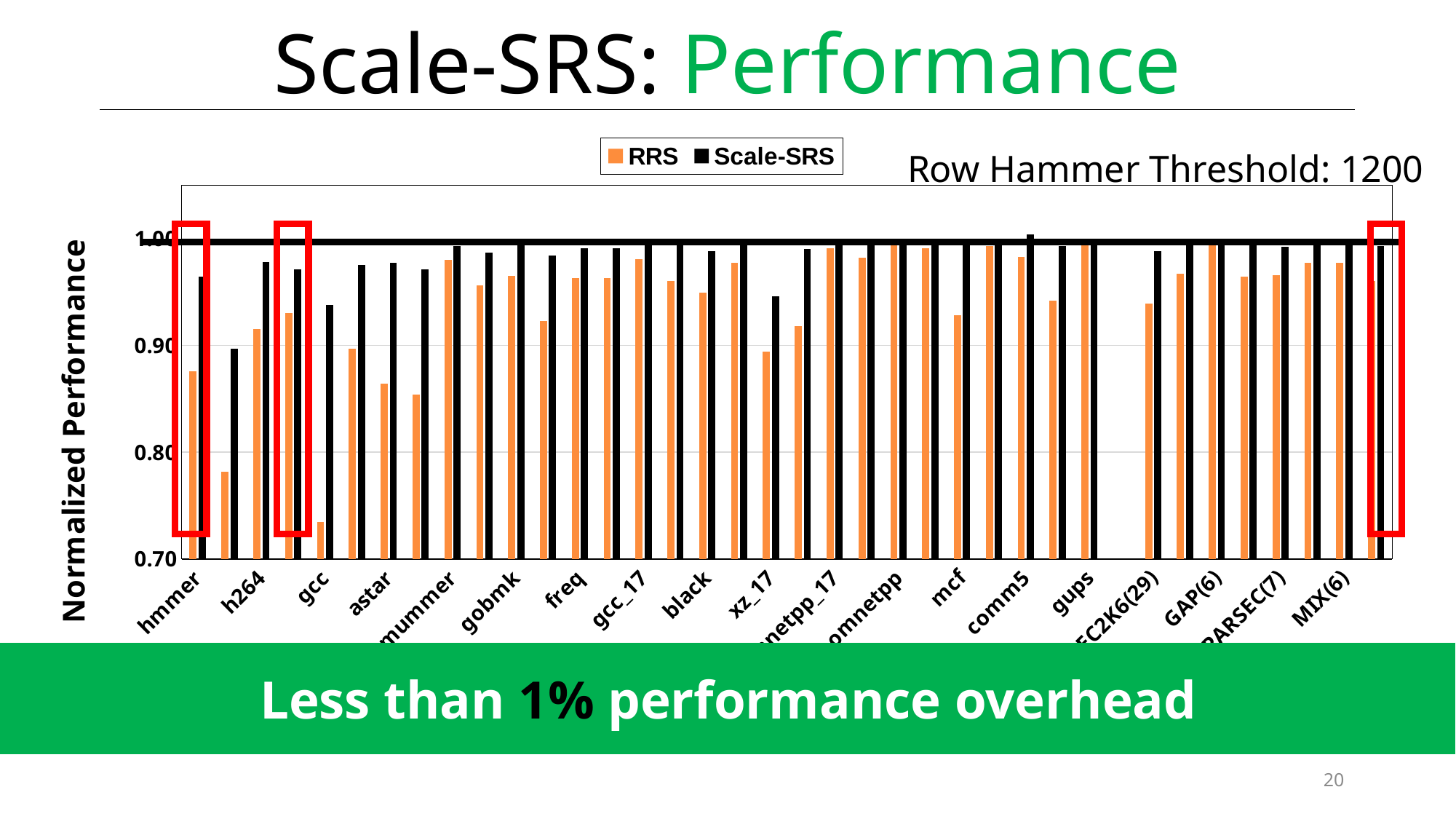
Which two series are listed in the chart legend? RRS and Scale-SRS Is the Scale-SRS value for astar greater or less than 0.90? greater What is the label of the chart's vertical axis? Normalized Performance What kind of chart is shown on the slide? bar chart How many series does the chart legend list? 2 For astar, which series has the larger value, RRS or Scale-SRS? Scale-SRS Is the RRS value for hmmer greater or less than 0.90? less Is the Scale-SRS value for hmmer greater or less than 0.90? greater For hmmer, which series has the larger value, RRS or Scale-SRS? Scale-SRS